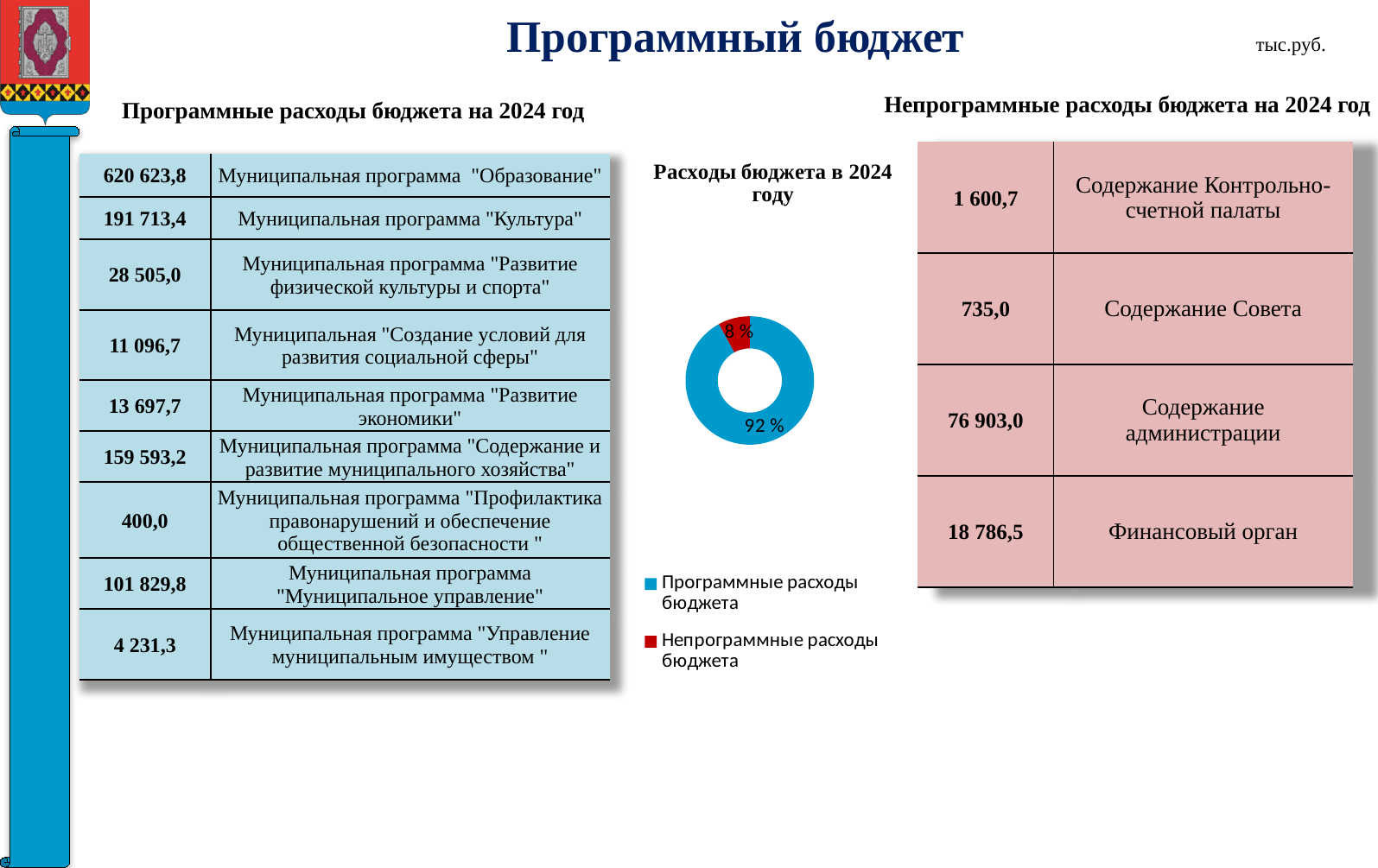
What is the title of the chart on the slide? Расходы бюджета в 2024 году How many slices does the chart have? 2 What colour is the "Непрограммные расходы бюджета" slice in the chart? Red How many entries does the chart's legend list? 2 Which is larger in the chart: "Программные расходы бюджета" or "Непрограммные расходы бюджета"? Программные расходы бюджета Which slice of the chart is the largest? Программные расходы бюджета Which slice of the chart is the smallest? Непрограммные расходы бюджета What share of the chart is labelled "Программные расходы бюджета"? 92 % By how many percentage points does the "Программные расходы бюджета" slice exceed the "Непрограммные расходы бюджета" slice? 84 What kind of chart is shown on the slide? Doughnut chart What share of the chart is labelled "Непрограммные расходы бюджета"? 8 %